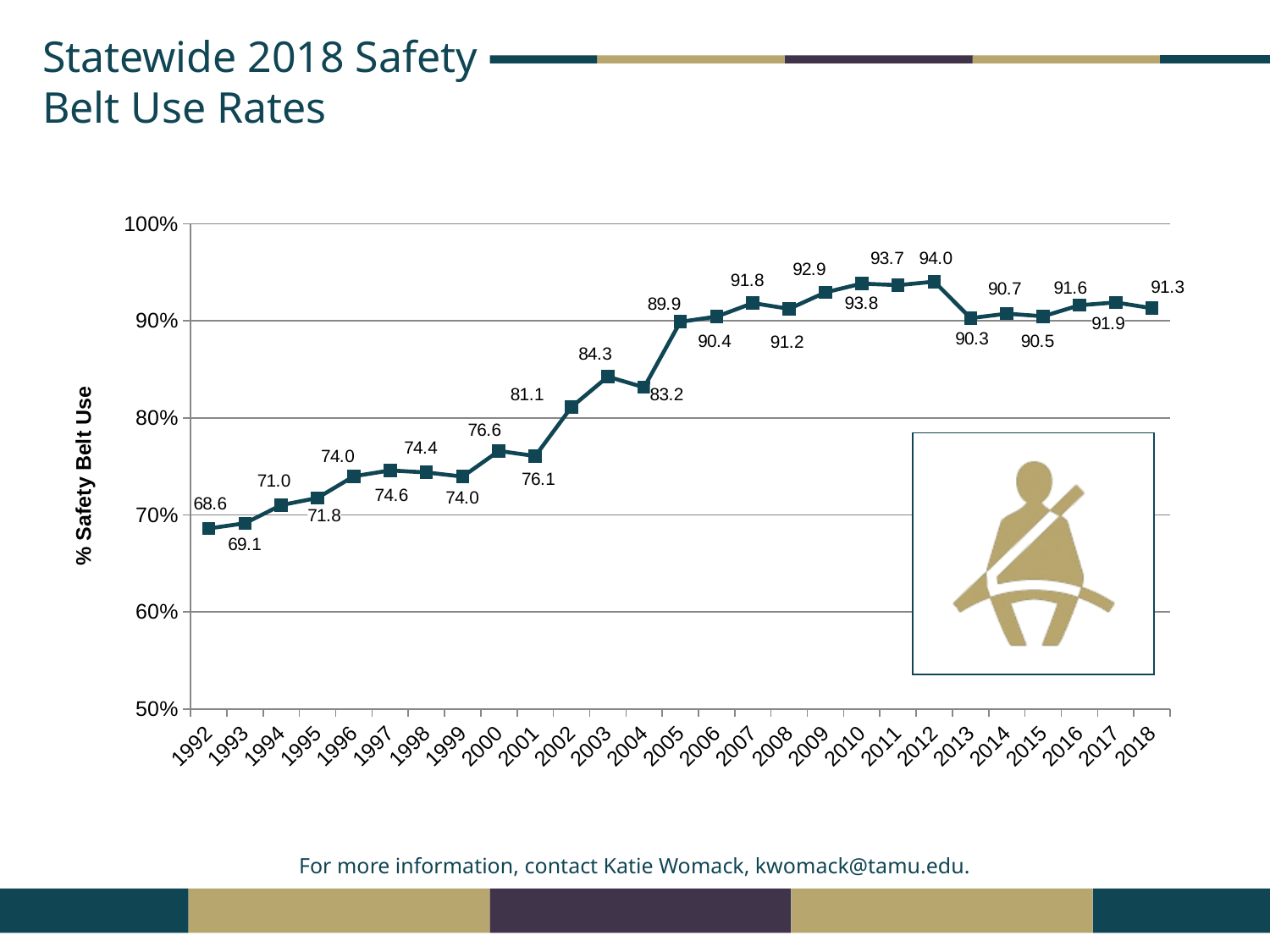
Which year has a higher safety belt use rate, 2003 or 2004? 2003 Is the value for 2002 greater or less than 80%? greater Which year has the highest safety belt use rate? 2012 Do the safety belt use rates generally rise or fall from 1992 to 2012? rise What is the safety belt use rate for 2018? 91.3 What is the difference between the 2012 and 2013 safety belt use rates? 3.7 What kind of chart is shown on the slide? line chart What is the label on the vertical axis of the chart? % Safety Belt Use Which year has the lowest safety belt use rate? 1992 How many years are plotted on the chart? 27 What is the safety belt use rate for 2005? 89.9 What is the safety belt use rate for 1992? 68.6